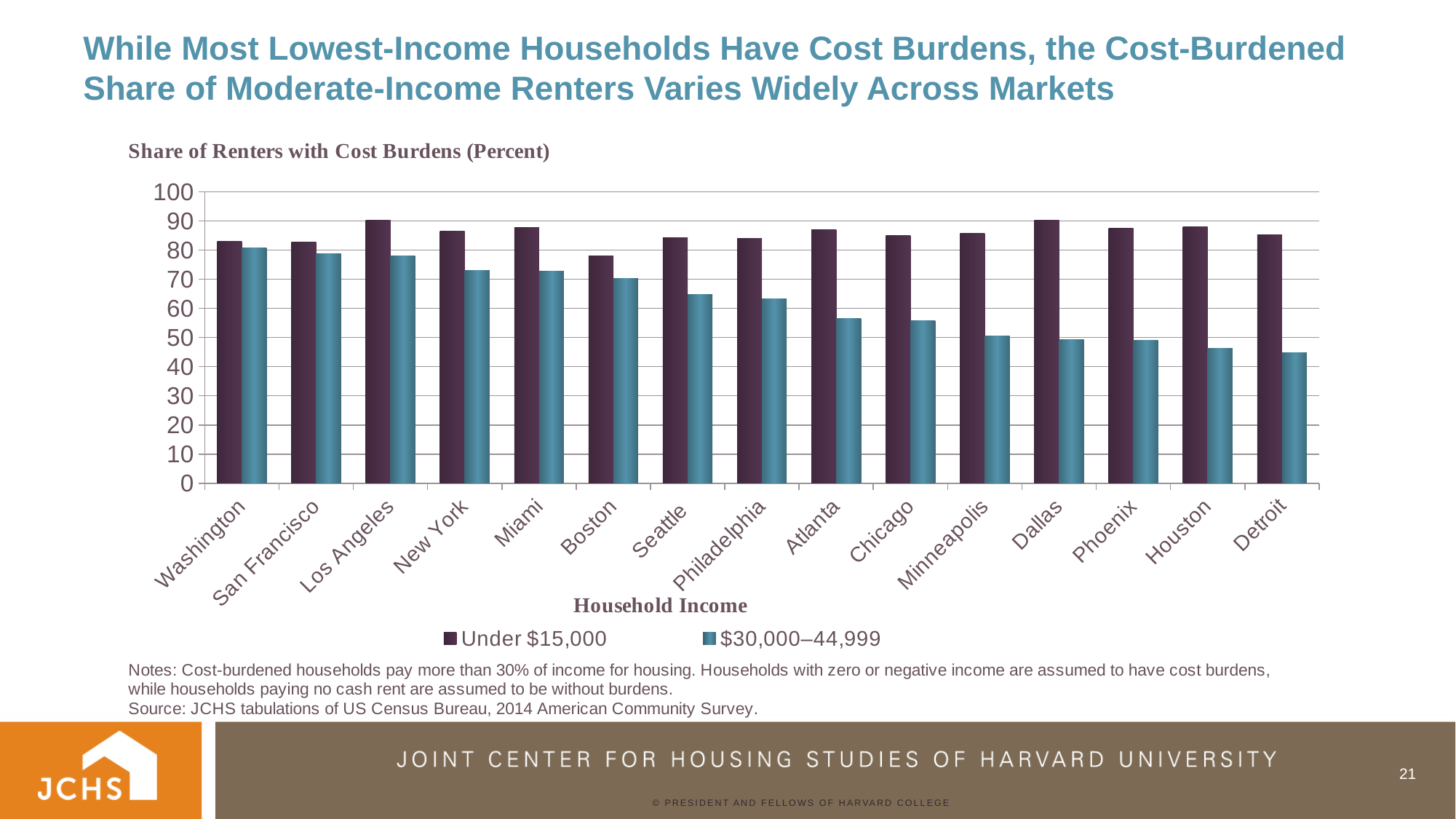
Is the value for Seattle in the $30,000–44,999 series greater or less than 60? greater Do the values for the $30,000–44,999 series generally rise or fall moving from Washington to Detroit along the x axis? fall How many metro areas are shown on the x axis of the chart? 15 What type of chart is shown on the slide? bar chart Which metro area has the lowest value for the Under $15,000 series? Boston Is the value for Los Angeles in the Under $15,000 series greater or less than 80? greater Is the value for Detroit in the $30,000–44,999 series greater or less than 50? less Which metro area has the lowest value for the $30,000–44,999 series? Detroit What is the label of the chart's x axis? Household Income How many series does the chart's legend list? 2 For Detroit, which series has the larger value: Under $15,000 or $30,000–44,999? Under $15,000